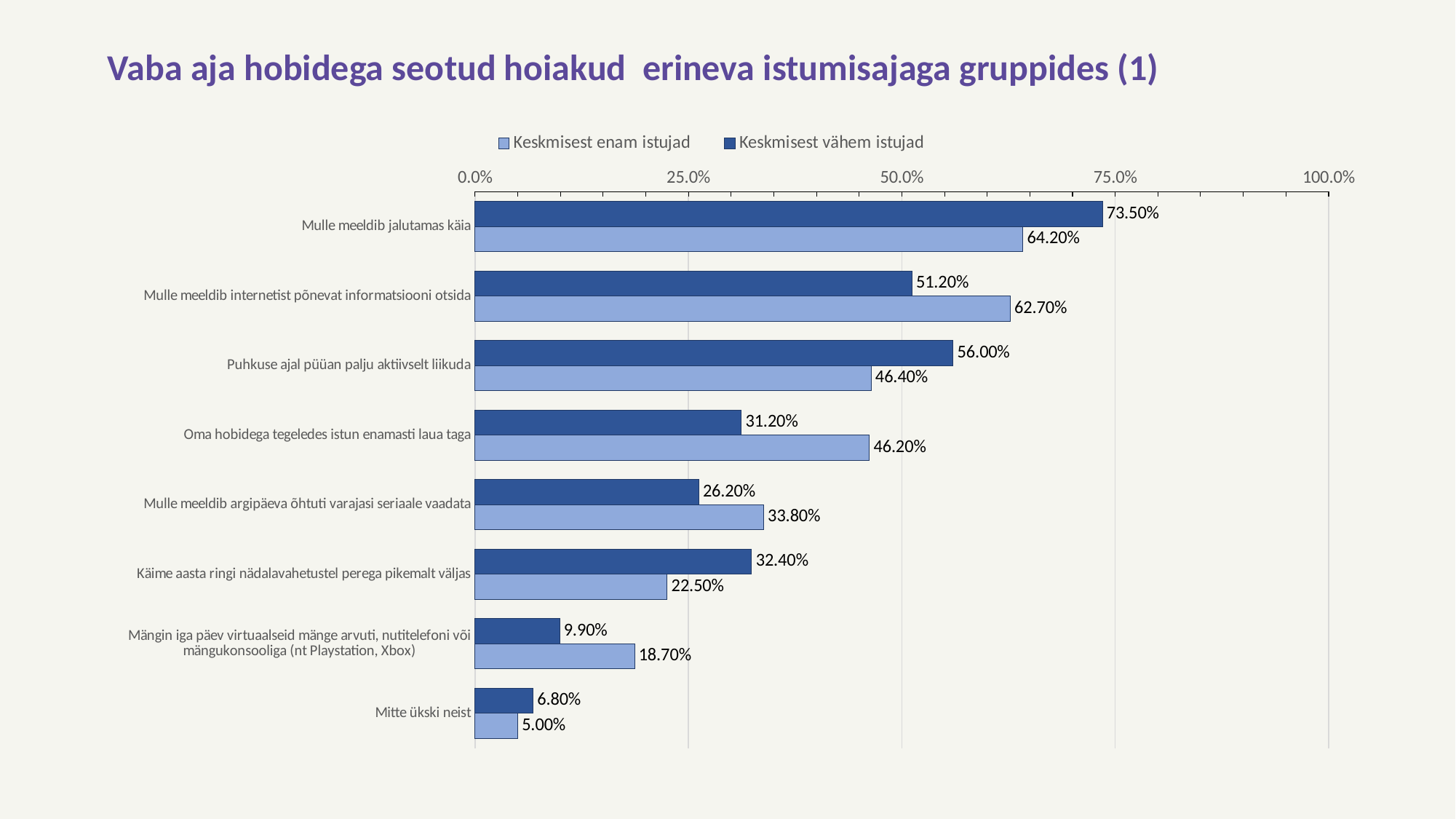
How many categories are shown on the chart? 8 What kind of chart is shown on the slide? Bar chart What is the difference between the "Keskmisest vähem istujad" and "Keskmisest enam istujad" values for "Puhkuse ajal püüan palju aktiivselt liikuda"? 9.60% Which category has the lowest value for "Keskmisest enam istujad"? Mitte ükski neist What is the value for "Keskmisest enam istujad" in the category "Mängin iga päev virtuaalseid mänge arvuti, nutitelefoni või mängukonsooliga (nt Playstation, Xbox)"? 18.70% What is the value for "Keskmisest vähem istujad" in the category "Mulle meeldib jalutamas käia"? 73.50% Is the value for "Keskmisest vähem istujad" in "Käime aasta ringi nädalavahetustel perega pikemalt väljas" greater or less than 25.0%? greater How many series does the legend list? 2 What is the title of the slide? Vaba aja hobidega seotud hoiakud erineva istumisajaga gruppides (1) Which category has the highest value for "Keskmisest vähem istujad"? Mulle meeldib jalutamas käia What is the value for "Keskmisest enam istujad" in the category "Mulle meeldib internetist põnevat informatsiooni otsida"? 62.70% For "Oma hobidega tegeledes istun enamasti laua taga", which series has the larger value? Keskmisest enam istujad